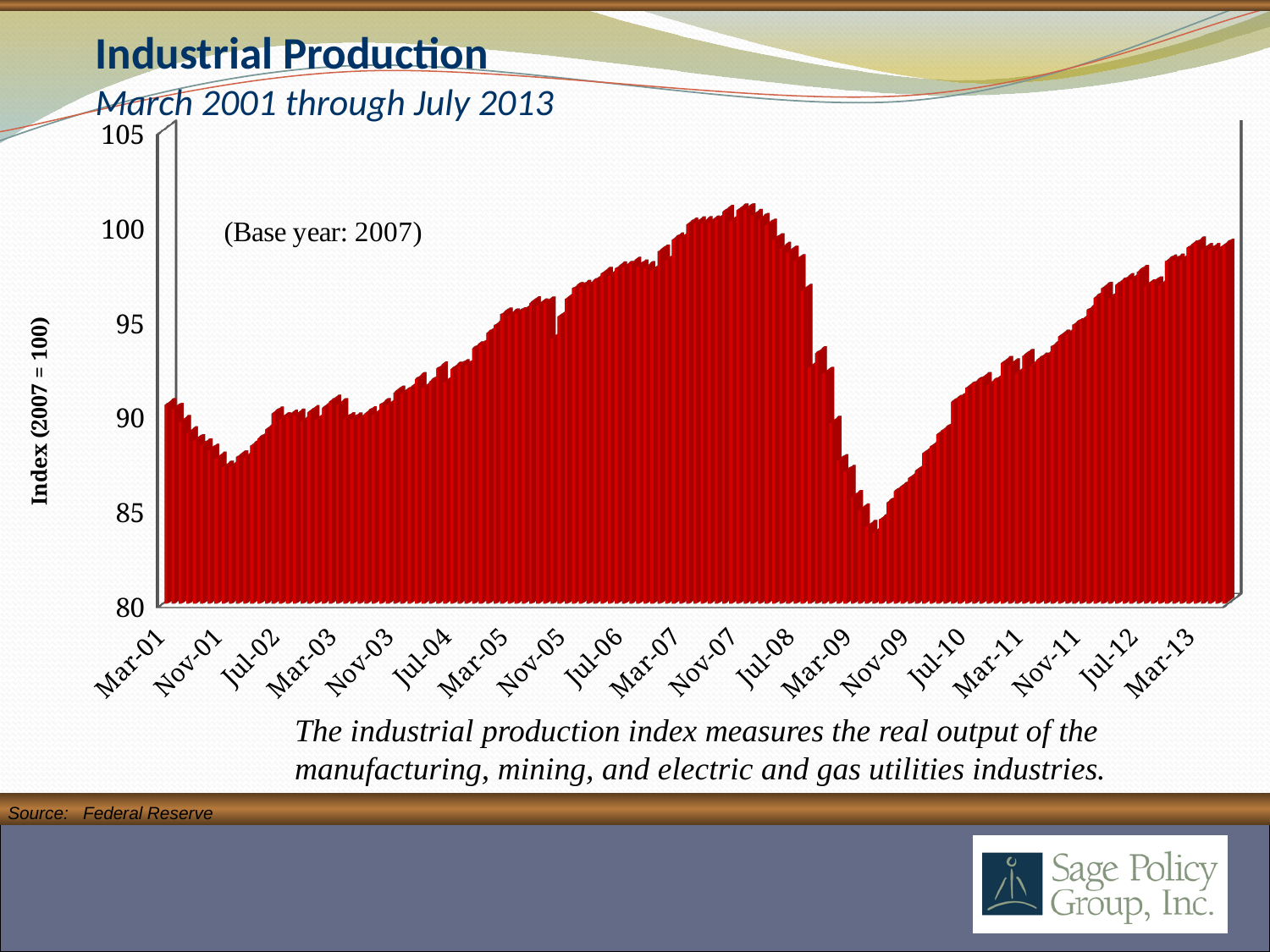
Is the value for Nov-07 greater or less than 100? greater Is the value for Mar-09 greater or less than 90? less Is the value for Jul-06 greater or less than 95? greater What kind of chart is shown on the slide? bar chart Do the values rise or fall between Nov-07 and Mar-09? fall Which is larger, the value for Mar-13 or the value for Mar-01? Mar-13 What base year is used for the index in the chart? 2007 What is the title of the chart on the slide? Industrial Production Do the values rise or fall between Nov-09 and Jul-12? rise Which is larger, the value for Nov-07 or the value for Mar-09? Nov-07